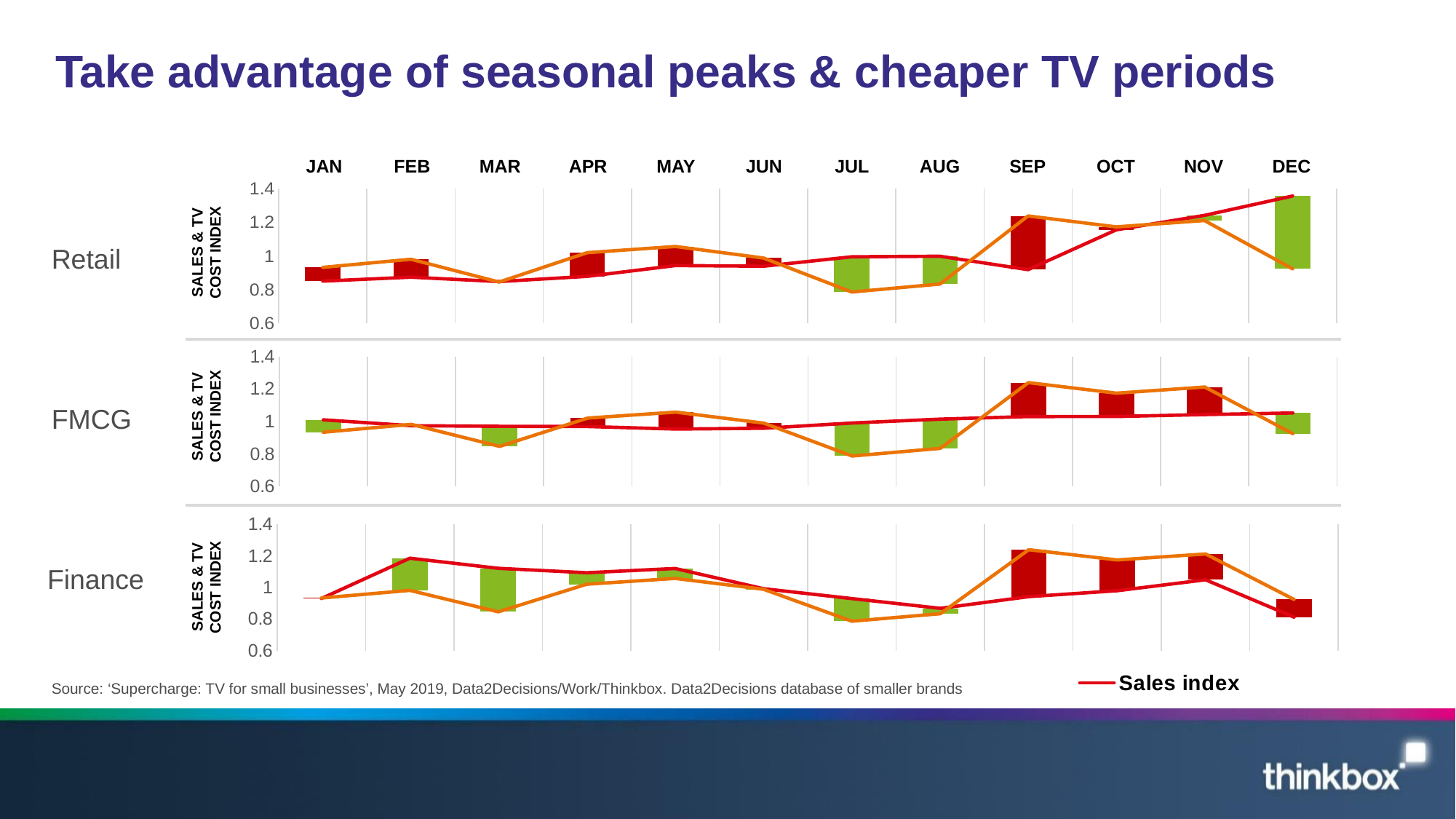
In the Retail chart, which month has the highest Sales index value? DEC In the Finance chart, is the Sales index value for FEB greater or less than 1? greater In the Retail chart, is the Sales index value for DEC greater or less than 1.2? greater In the FMCG chart, is the Sales index value for DEC greater or less than 1? greater What kind of chart is the FMCG chart? combination bar and line chart In the Retail chart, is the Sales index value larger in DEC or in JAN? DEC Which series is named in the legend at the bottom of the slide? Sales index In the Finance chart, which month has the lowest Sales index value? DEC In the Retail chart, does the Sales index rise or fall from SEP to DEC? rise In the Retail chart, how many months are plotted along the x axis? 12 How many charts are shown on the slide? 3